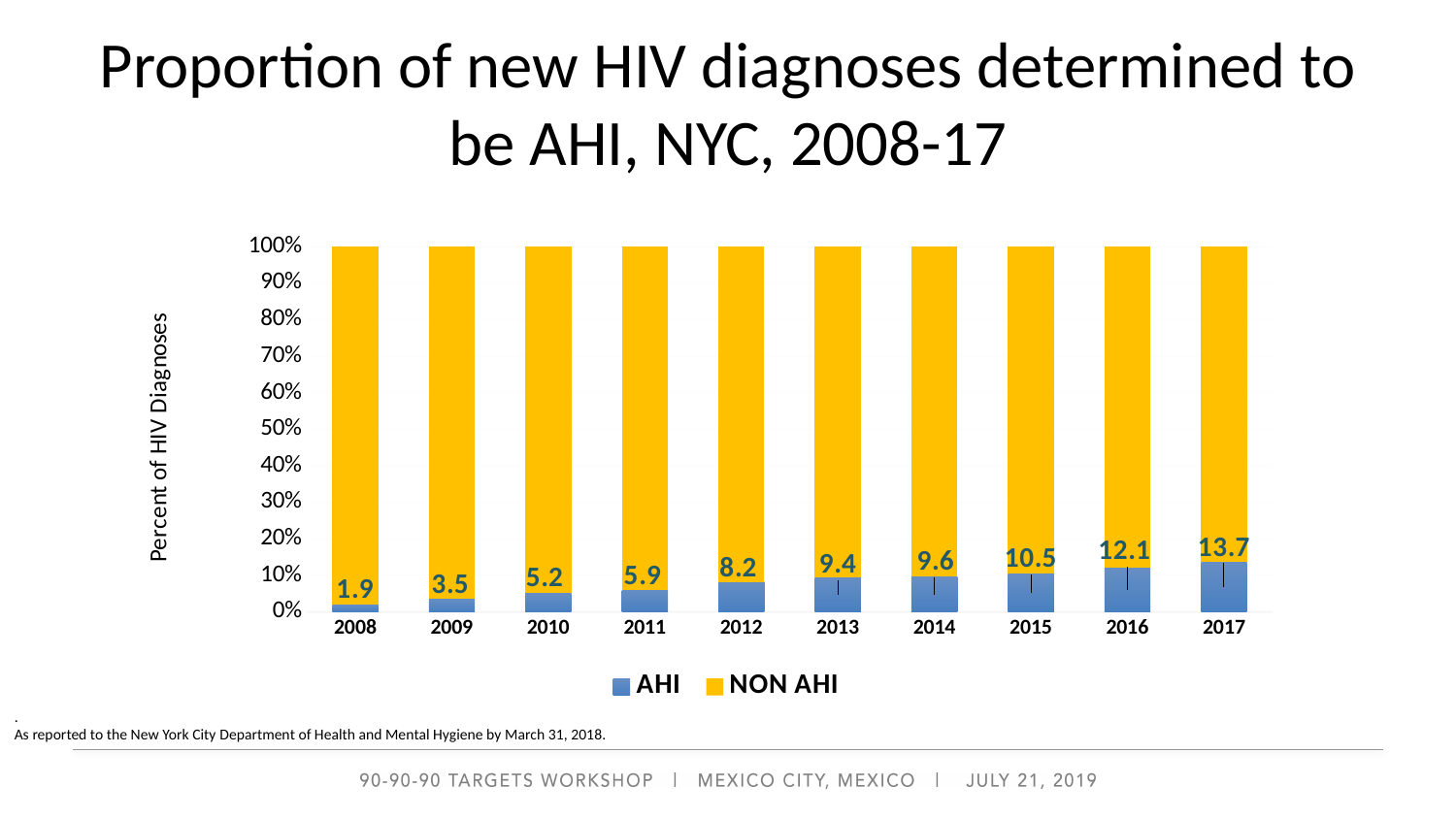
How many years are shown on the x axis? 10 What is the AHI value for 2008? 1.9 What is the difference between the AHI values for 2017 and 2008? 11.8 Which year has the highest AHI value? 2017 Which year has the lowest AHI value? 2008 Is the NON AHI value for 2008 greater or less than 90%? greater Which year has a larger AHI value, 2012 or 2010? 2012 What is the AHI value for 2013? 9.4 What is the difference between the AHI values for 2016 and 2015? 1.6 How many series does the legend list? 2 What is the AHI value for 2017? 13.7 Does the AHI value rise or fall from 2008 to 2017? rise